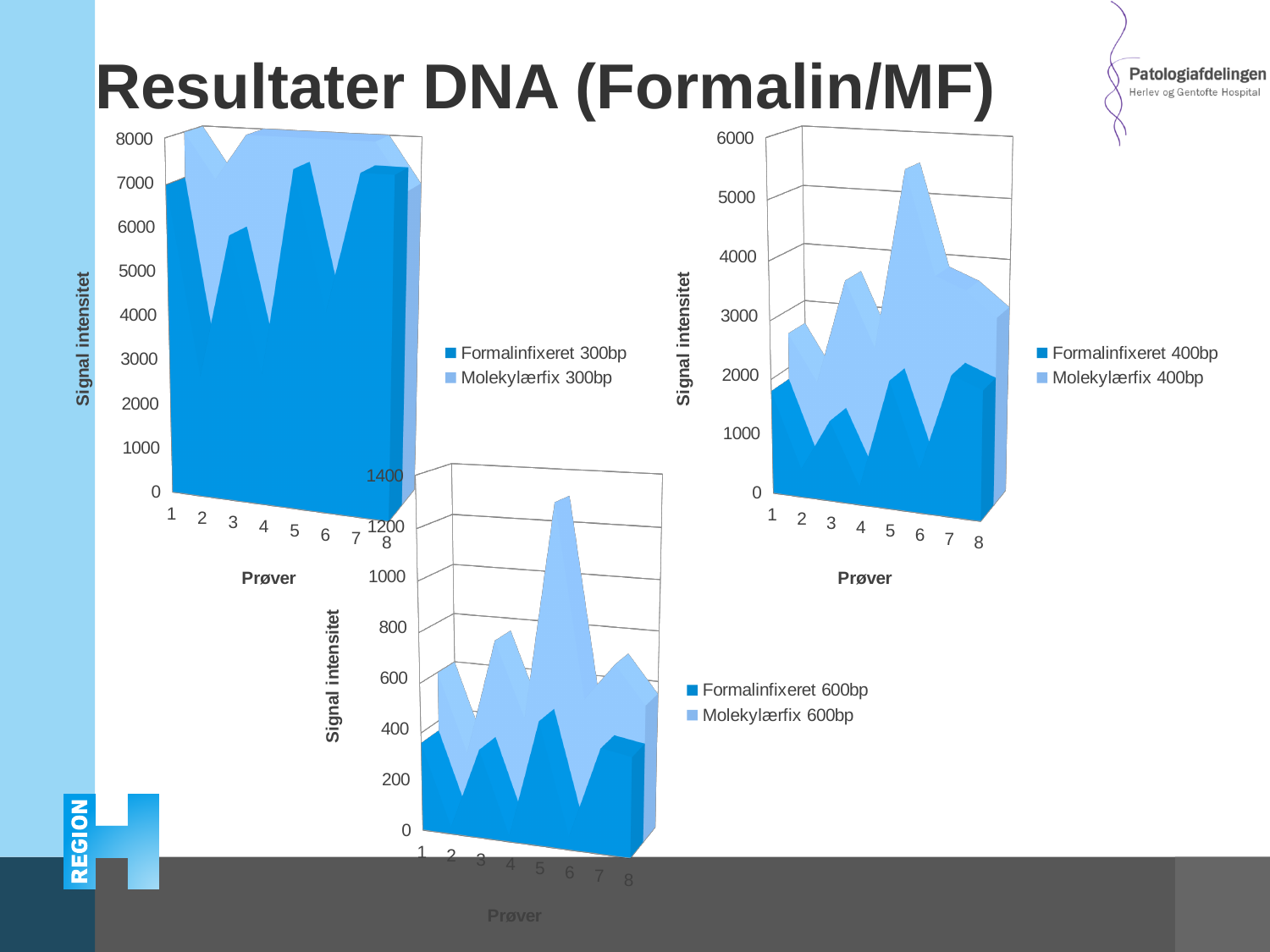
What are the two legend entries of the bottom chart? Formalinfixeret 600bp and Molekylærfix 600bp In the bottom chart, which sample has the highest value for Molekylærfix 600bp? 5 How many samples (Prøver) are shown on the x axis of the top-right chart? 8 What kind of chart is the top-left chart on the slide? area chart How many series does the legend of the top-left chart list? 2 In the bottom chart, is the value for Formalinfixeret 600bp at sample 1 greater or less than 600? less What is the y-axis title of the top-right chart? Signal intensitet In the top-right chart, is the value for Formalinfixeret 400bp at sample 1 greater or less than 3000? less In the top-right chart, which sample has the highest value for Molekylærfix 400bp? 5 In the top-right chart, is the value for Molekylærfix 400bp at sample 5 greater or less than 5000? greater